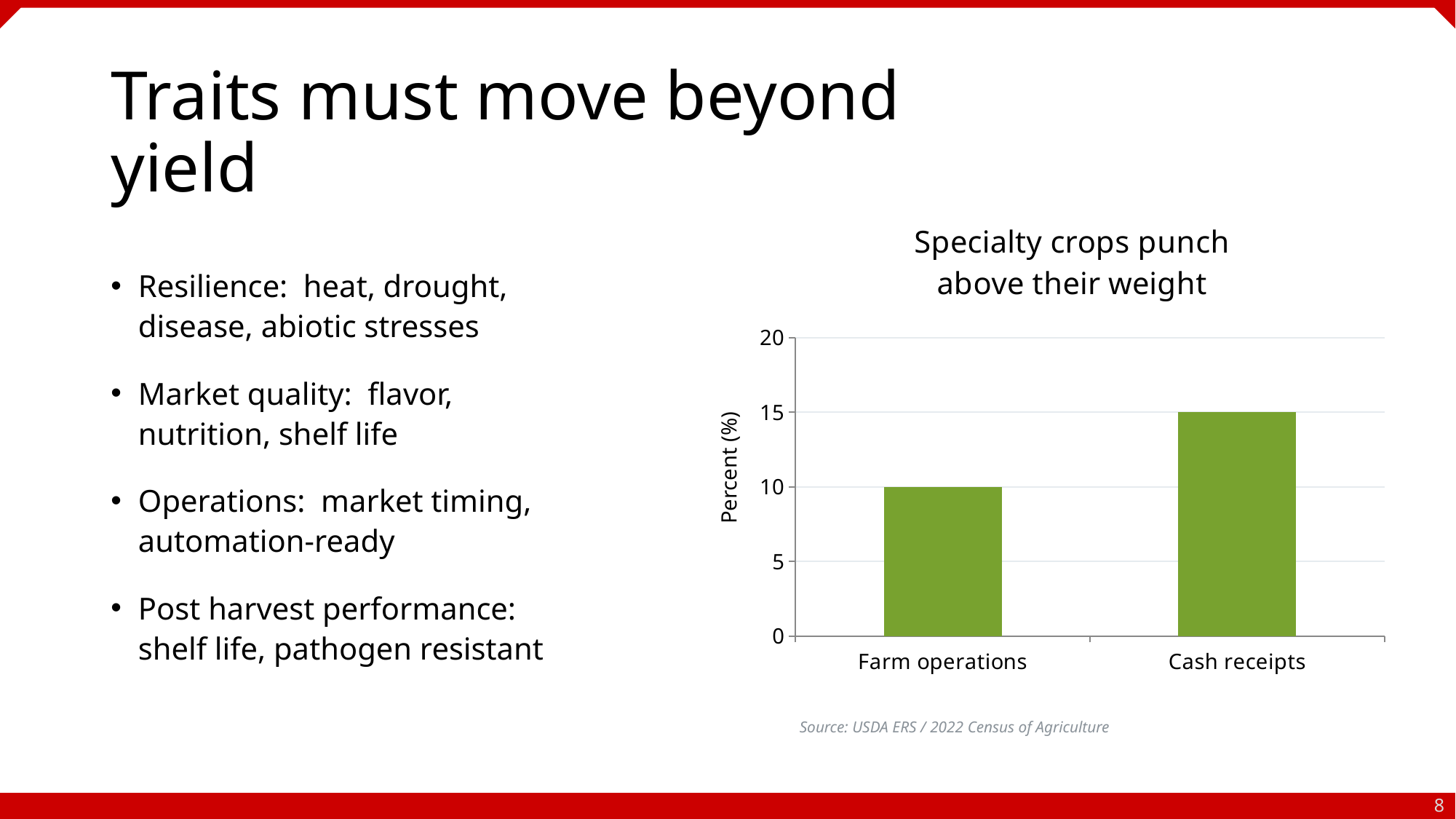
What is the label of the y axis? Percent (%) Which category has the lowest value? Farm operations What kind of chart is shown on the slide? bar chart Is the value for Farm operations greater or less than 5? greater What is the title of the chart? Specialty crops punch above their weight How many categories are shown on the x axis? 2 What is the value for Farm operations? 10 What is the difference between the values for Cash receipts and Farm operations? 5 Which is larger, the value for Farm operations or the value for Cash receipts? Cash receipts Is the value for Cash receipts greater or less than 20? less Which category has the highest value? Cash receipts What is the value for Cash receipts? 15